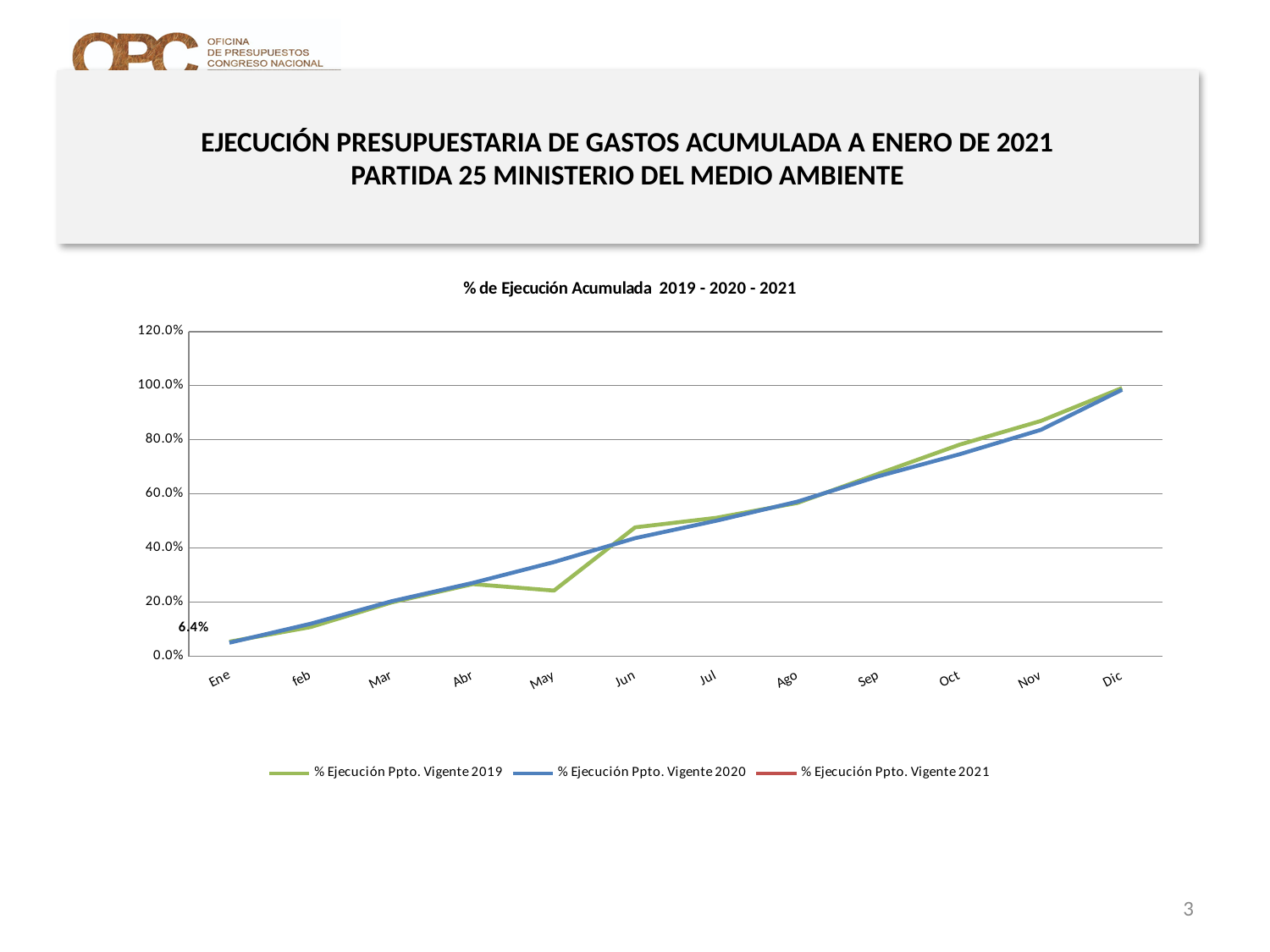
In which month does % Ejecución Ppto. Vigente 2019 reach its highest value? Dic What is the title of the chart? % de Ejecución Acumulada 2019 - 2020 - 2021 Is the value for % Ejecución Ppto. Vigente 2020 in Dic greater or less than 80.0%? greater Is the value for % Ejecución Ppto. Vigente 2019 in May greater or less than 40.0%? less How many series does the chart legend list? 3 What kind of chart is shown on the slide? line chart What value is printed as a data label at Ene on the chart? 6.4% Do the values for % Ejecución Ppto. Vigente 2020 rise or fall from Ene to Dic? rise What colour is the line for % Ejecución Ppto. Vigente 2020 in the legend? blue Is the value for % Ejecución Ppto. Vigente 2020 in Mar greater or less than 40.0%? less How many months are shown along the x axis of the chart? 12 In May, which series has the higher value: % Ejecución Ppto. Vigente 2019 or % Ejecución Ppto. Vigente 2020? % Ejecución Ppto. Vigente 2020